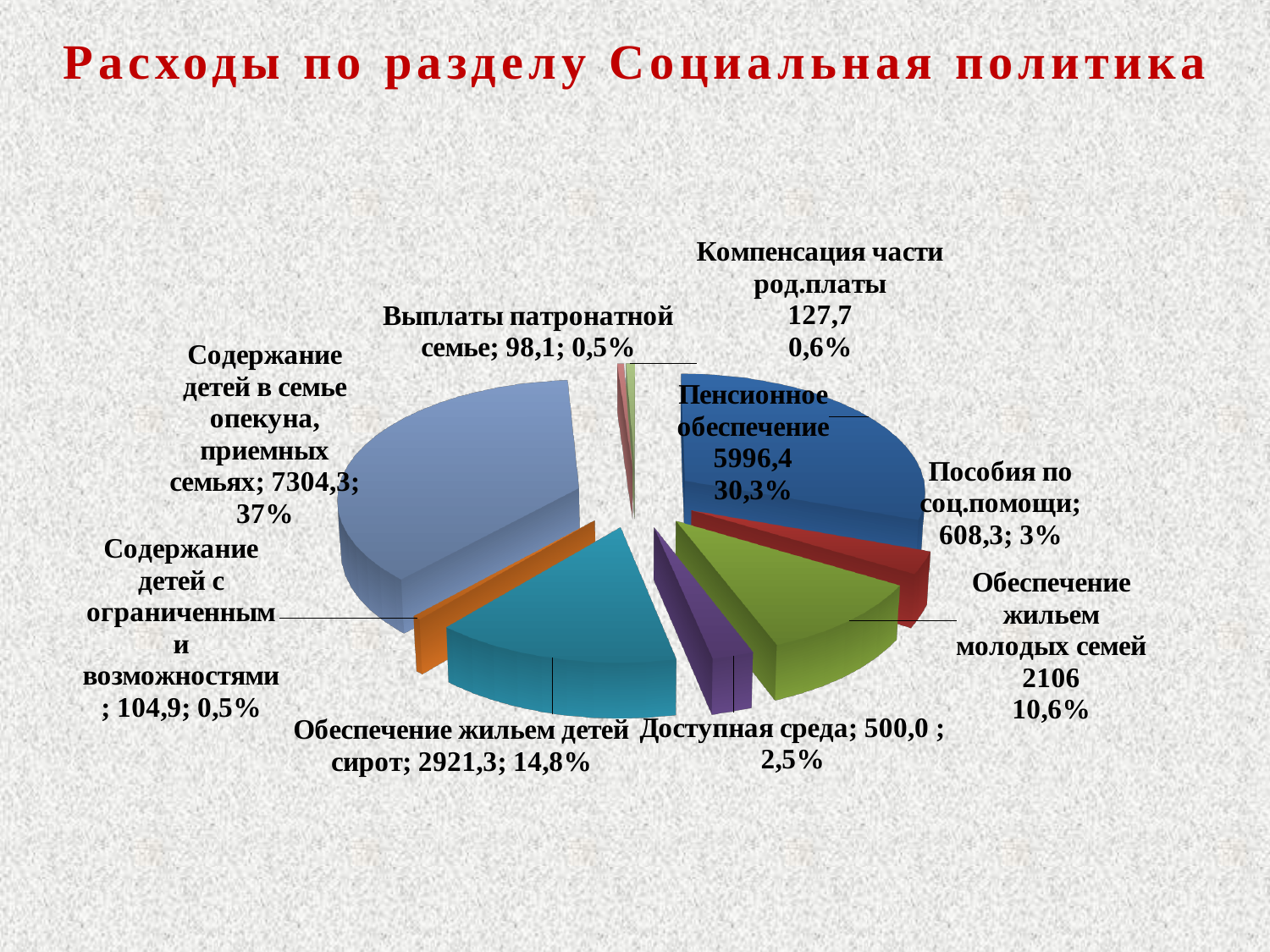
What is the value for Пенсионное обеспечение? 5996,4 How many categories (slices) does the pie chart have? 9 Which is larger: the value for Компенсация части род.платы or the value for Содержание детей с ограниченными возможностями? Компенсация части род.платы What share of the pie does Обеспечение жильем молодых семей represent? 10,6% What is the difference between the values for Пособия по соц.помощи and Доступная среда? 108,3 What is the title of the chart? Расходы по разделу Социальная политика What is the value for Доступная среда? 500,0 What kind of chart is shown on the slide? Pie chart What share of the pie does Пособия по соц.помощи represent? 3% Which category has the smallest value? Выплаты патронатной семье What share of the pie does Обеспечение жильем детей сирот represent? 14,8% Which category has the largest share of the pie? Содержание детей в семье опекуна, приемных семьях